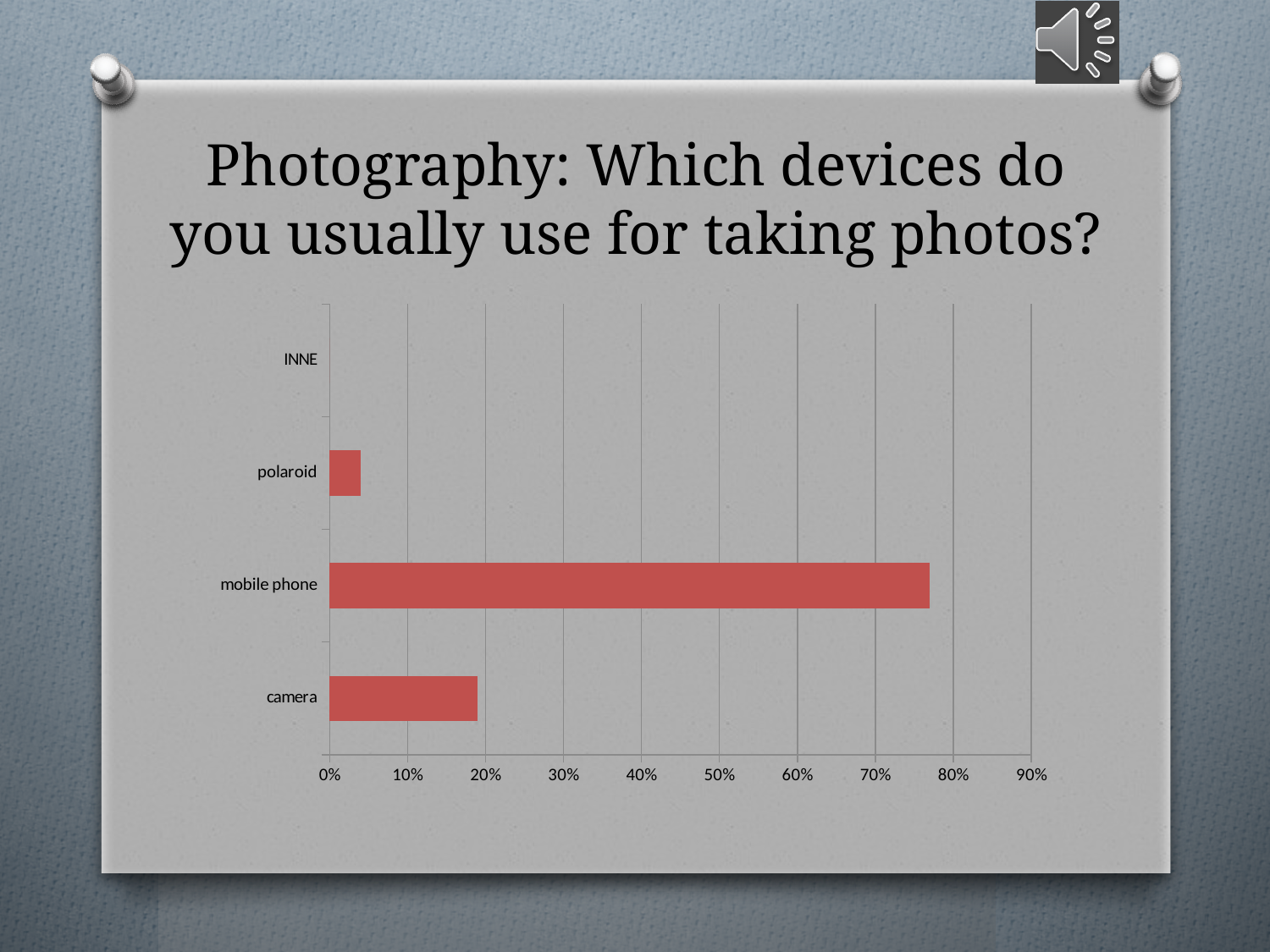
Which has a larger value, mobile phone or camera? mobile phone How many categories are listed on the vertical axis of the chart? 4 Which has a larger value, camera or polaroid? camera What kind of chart is shown on the slide? bar chart Is the value for camera greater or less than 10%? greater Which device has the highest value in the chart? mobile phone What is the highest tick label shown on the horizontal axis of the chart? 90% Among the categories with a visible bar, which has the lowest value? polaroid Is the value for mobile phone greater or less than 70%? greater Is the value for polaroid greater or less than 10%? less